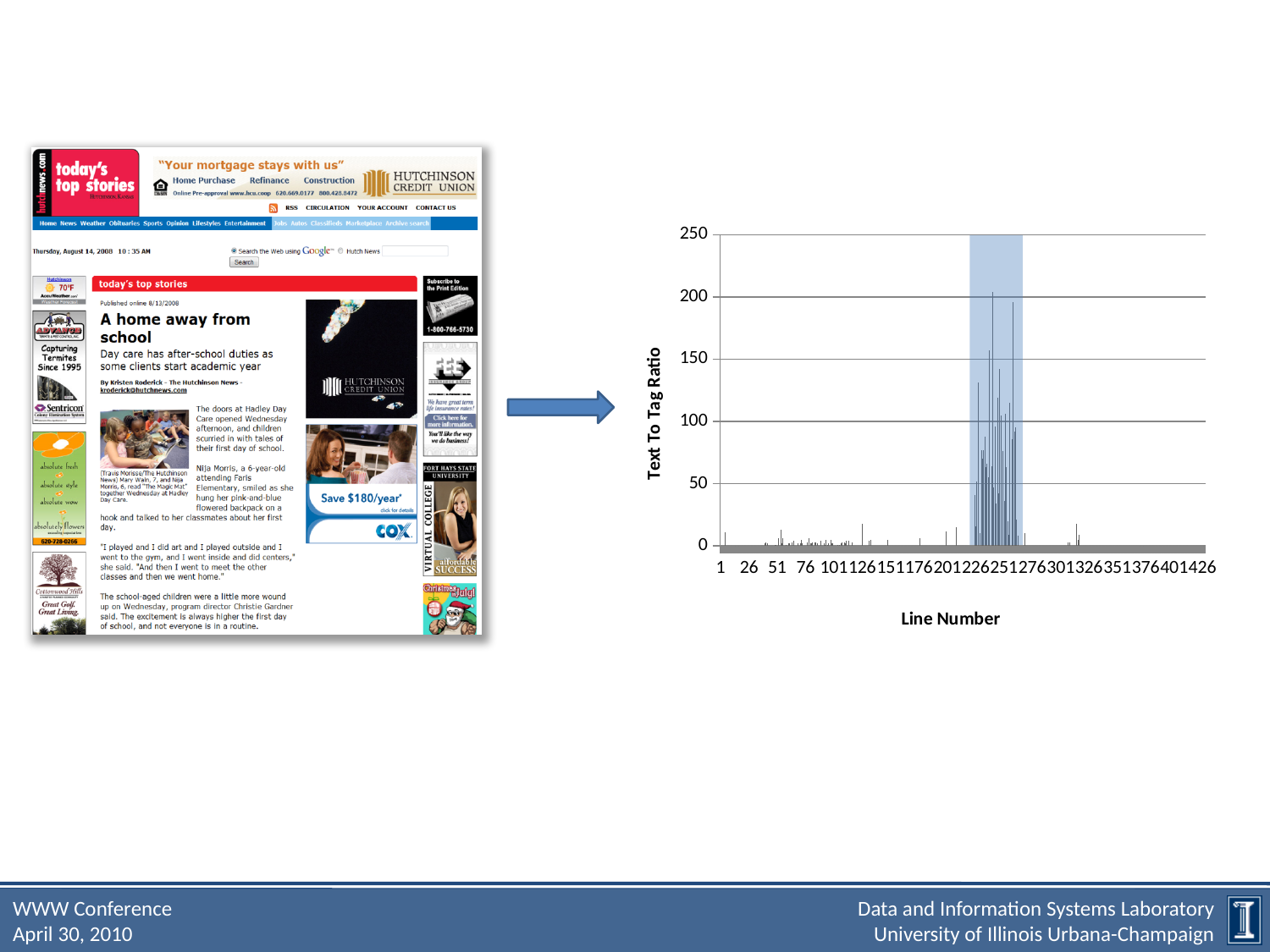
Is the highest Text To Tag Ratio value in the chart greater or less than 250? less Are the Text To Tag Ratio values for line numbers between 1 and 26 greater or less than 50? less Are the Text To Tag Ratio values for line numbers around 401 to 426 greater or less than 50? less What is the label of the vertical axis of the chart? Text To Tag Ratio What is the maximum value shown on the vertical axis of the chart? 250 What kind of chart is shown on the right side of the slide? bar chart How many tick labels are shown on the horizontal axis of the chart? 18 What is the label of the horizontal axis of the chart? Line Number Between which two horizontal-axis tick labels does the shaded region with the tallest bars lie? 226 and 276